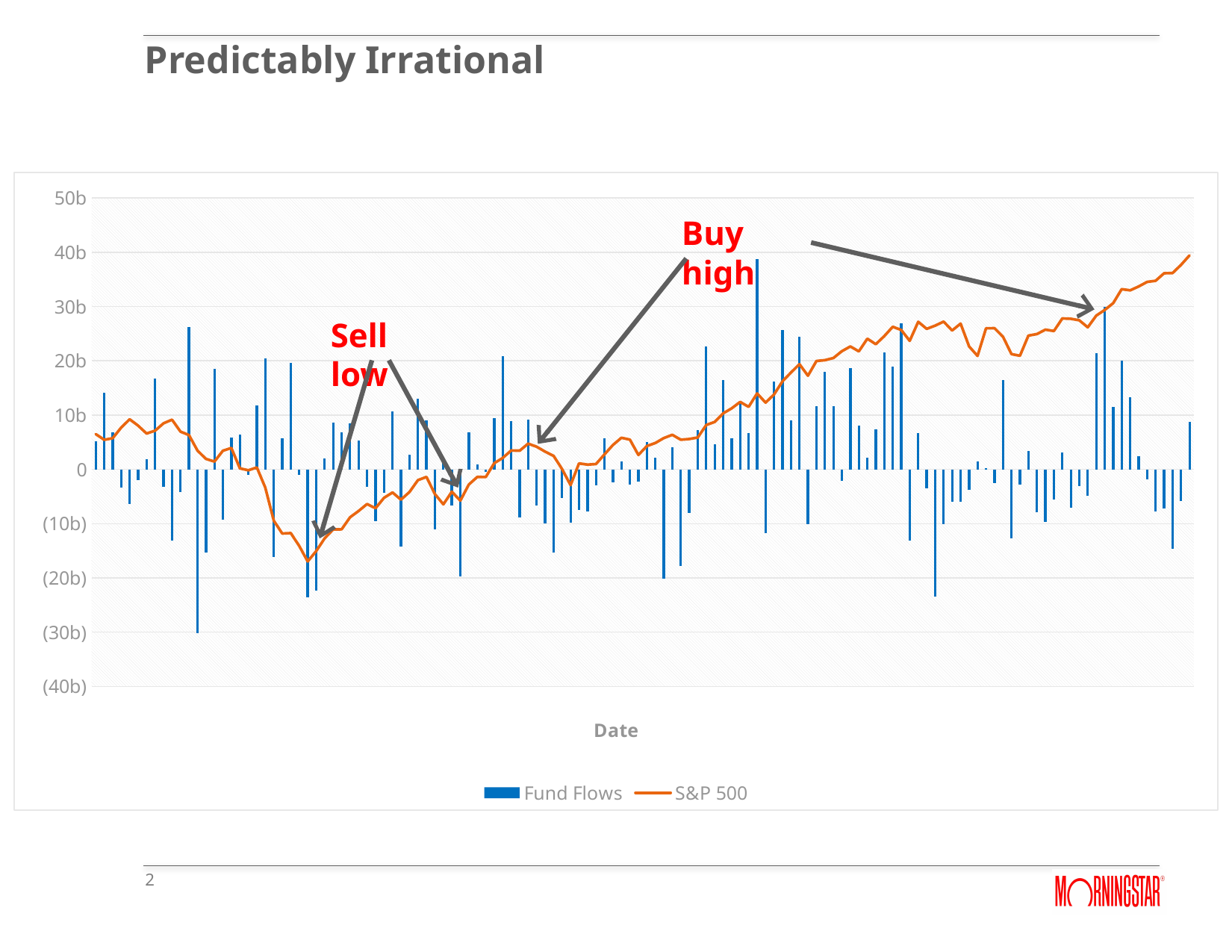
What kind of chart is shown on the slide? A combination bar and line chart Does the S&P 500 line end higher or lower than where it starts? Higher Which series is plotted as bars? Fund Flows How many series does the legend list? 2 Does the S&P 500 line overall rise or fall from the left of the chart to the right? Rise Is the tallest Fund Flows bar greater or less than 30b? greater What are the two series named in the legend? Fund Flows and S&P 500 Is the lowest Fund Flows bar greater or less than (20b)? less